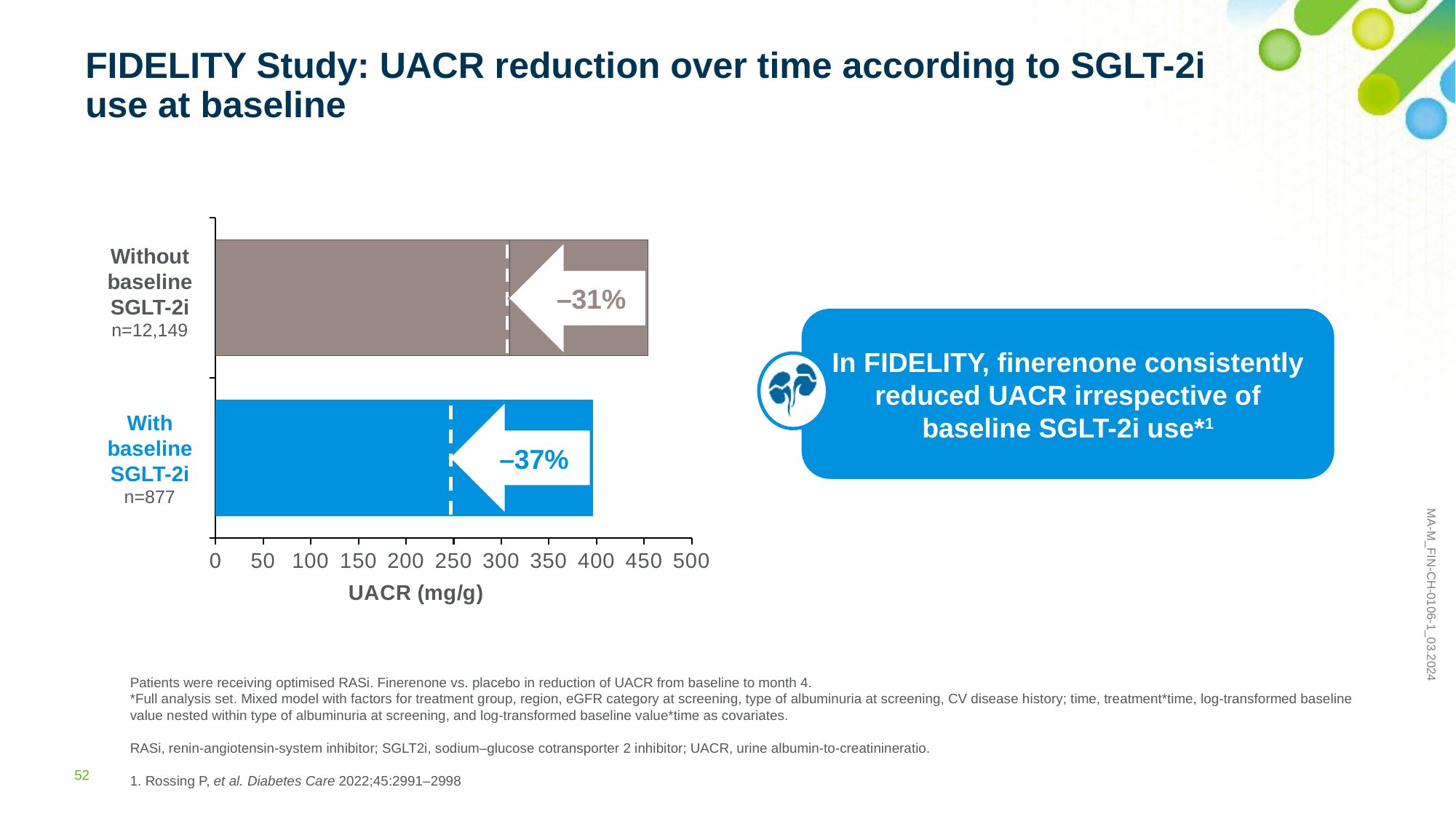
Which bar is longer: the one for patients without baseline SGLT-2i or the one for patients with baseline SGLT-2i? Without baseline SGLT-2i What kind of chart is shown on the slide? bar chart What is the title of the x axis of the chart? UACR (mg/g) Is the bar for patients without baseline SGLT-2i greater or less than 400 mg/g? greater How many categories (bars) does the chart show? 2 Which category has the longer bar (higher UACR value)? Without baseline SGLT-2i Is the bar for patients with baseline SGLT-2i greater or less than 450 mg/g? less What percentage reduction in UACR is labelled on the bar for patients with baseline SGLT-2i? –37% What percentage reduction in UACR is labelled on the bar for patients without baseline SGLT-2i? –31% Which category has the shorter bar (lower UACR value)? With baseline SGLT-2i Is the bar for patients with baseline SGLT-2i greater or less than 350 mg/g? greater What is the number of patients (n) shown for the 'With baseline SGLT-2i' category? n=877